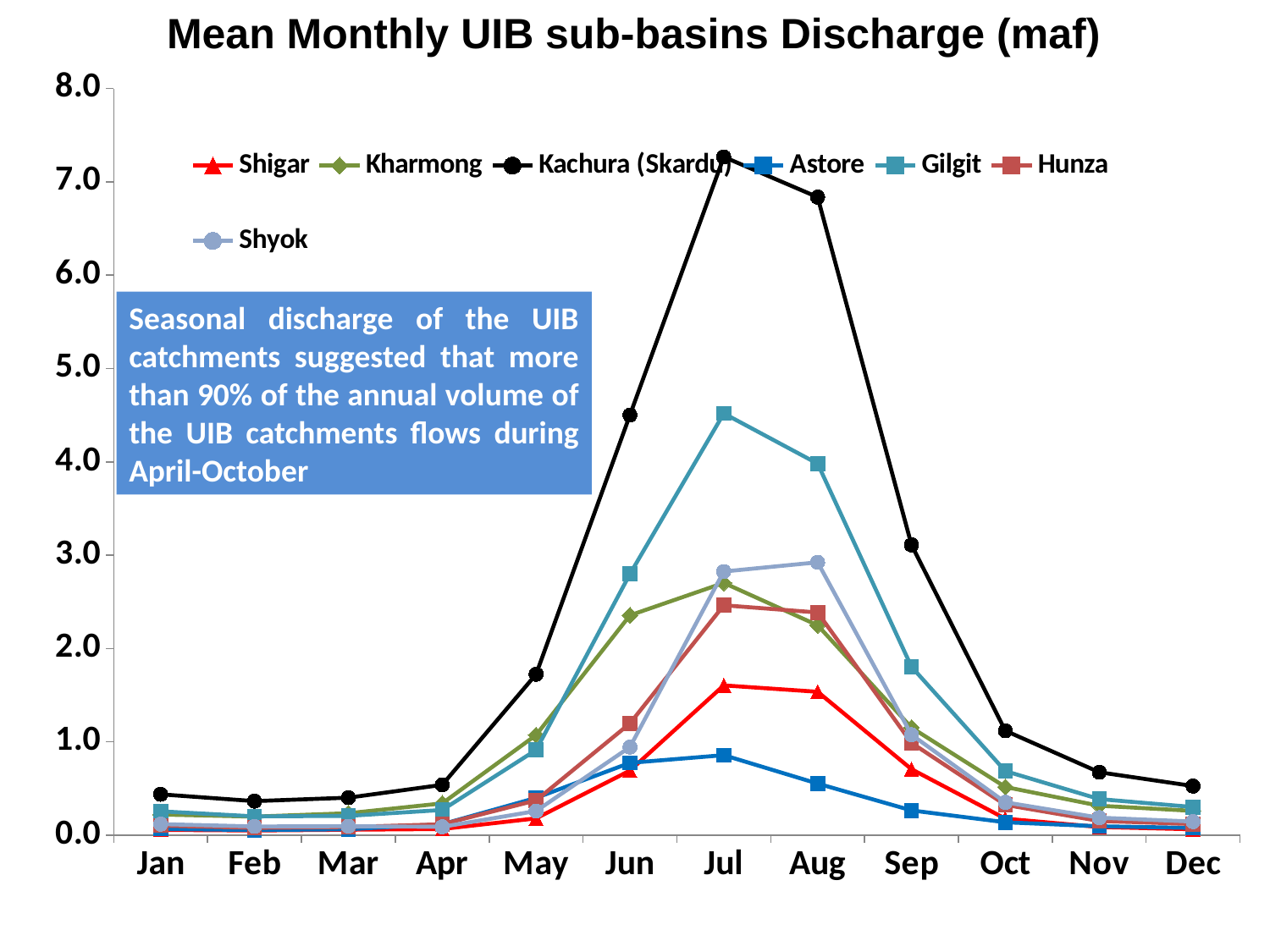
Is the value for Kachura (Skardu) in Jul greater or less than 7.0? greater In Jul, which series has the larger value, Gilgit or Shigar? Gilgit How many series does the legend list? 7 What is the title of the chart? Mean Monthly UIB sub-basins Discharge (maf) Is the value for Astore in Aug greater or less than 1.0? less In which month does the Kachura (Skardu) series reach its highest value? Jul Is the value for Gilgit in Jul greater or less than 4.0? greater Which series has the lowest value in Jul? Astore What kind of chart is shown on the slide? line chart Which series has the highest value in Aug? Kachura (Skardu) Do the Kachura (Skardu) values rise or fall from Jul to Dec? fall How many months are plotted along the x axis? 12